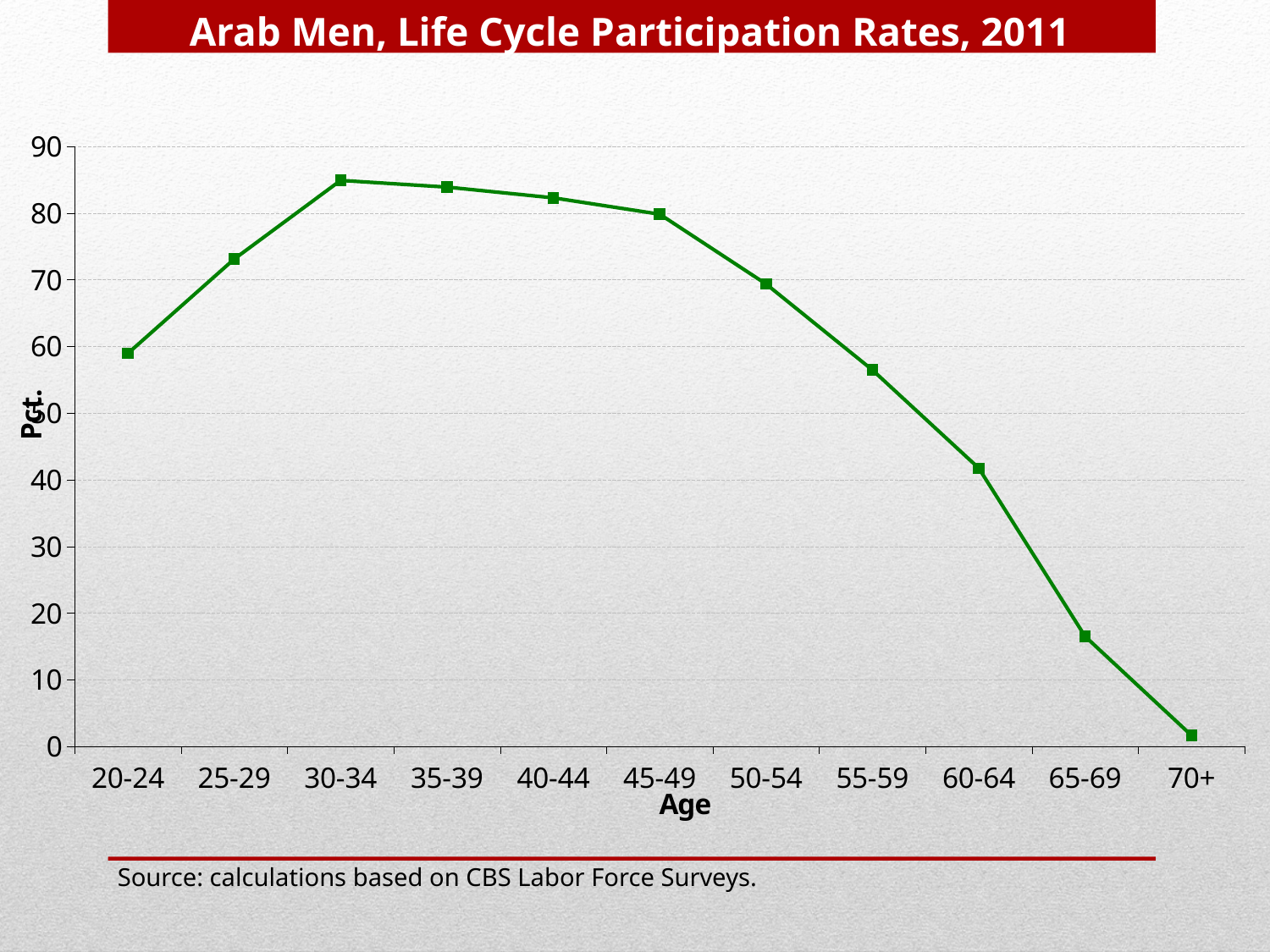
Do the participation rates rise or fall from the 45-49 age group to the 70+ age group? fall Is the value for the 65-69 age group greater or less than 20? less What kind of chart is shown on the slide? line chart How many age groups are plotted along the x axis? 11 Which age group has the highest participation rate? 30-34 What is the title of the chart? Arab Men, Life Cycle Participation Rates, 2011 Is the value for the 25-29 age group greater or less than 70? greater Which age group has the lowest participation rate? 70+ Is the value for the 60-64 age group greater or less than 40? greater Which age group has a higher participation rate, 50-54 or 55-59? 50-54 What is the label of the y axis? Pct.